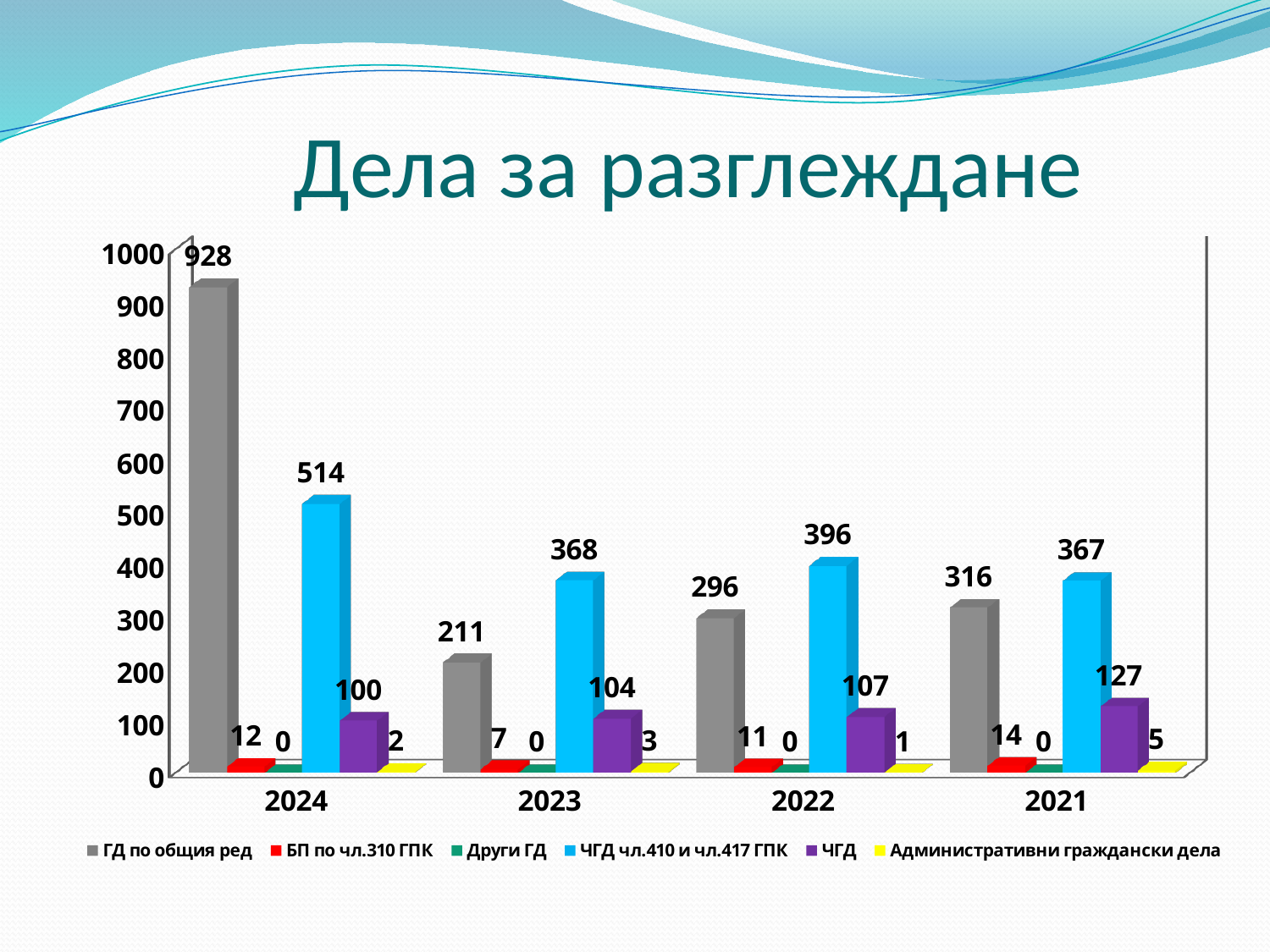
In which year is the value for ГД по общия ред the lowest? 2023 What is the value for ЧГД чл.410 и чл.417 ГПК in 2022? 396 What kind of chart is shown on the slide? Bar chart In which year is the value for ЧГД чл.410 и чл.417 ГПК the highest? 2024 What is the title of the chart? Дела за разглеждане What is the value for БП по чл.310 ГПК in 2023? 7 What is the value for ГД по общия ред in 2024? 928 Which is larger in 2021: ГД по общия ред or ЧГД чл.410 и чл.417 ГПК? ЧГД чл.410 и чл.417 ГПК How many series does the legend list? 6 How many years are shown on the x axis? 4 What is the difference between the ГД по общия ред values for 2024 and 2023? 717 What is the value for ЧГД in 2021? 127